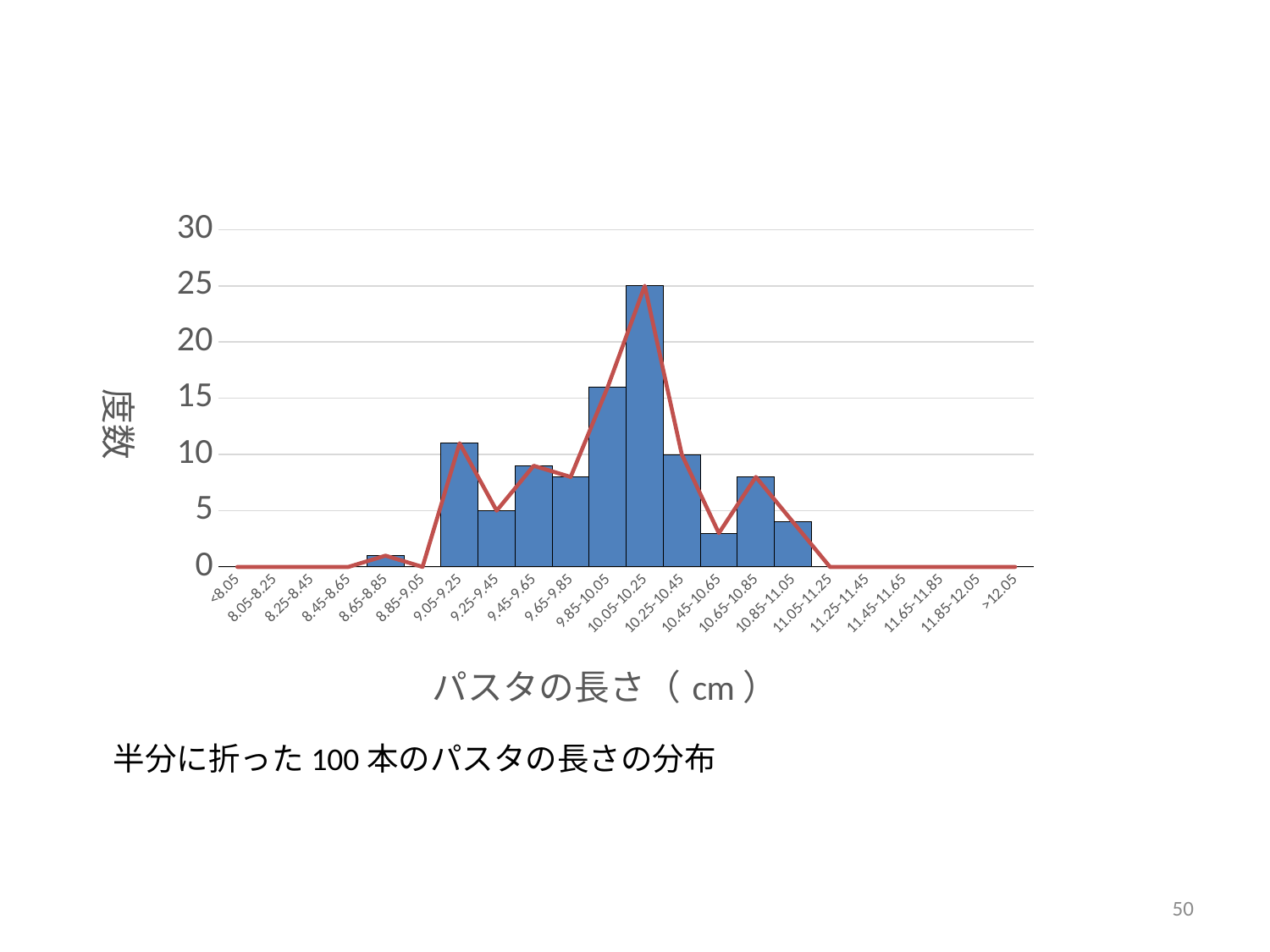
What is the title of the x axis? パスタの長さ（cm） What is the frequency for the 10.05-10.25 range? 25 What is the frequency for the 9.25-9.45 range? 5 Is the frequency for the 9.85-10.05 range greater or less than 15? greater Which length range has the highest frequency? 10.05-10.25 Is the frequency for the 9.05-9.25 range greater or less than 10? greater Is the frequency for the 10.85-11.05 range greater or less than 5? less What type of chart is shown on the slide? Bar chart (histogram) with a line overlay What is the frequency for the 10.25-10.45 range? 10 What is the difference between the frequencies of the 10.05-10.25 and 10.25-10.45 ranges? 15 Which has a higher frequency, the 9.85-10.05 range or the 10.25-10.45 range? 9.85-10.05 How many length ranges are shown on the x axis? 22